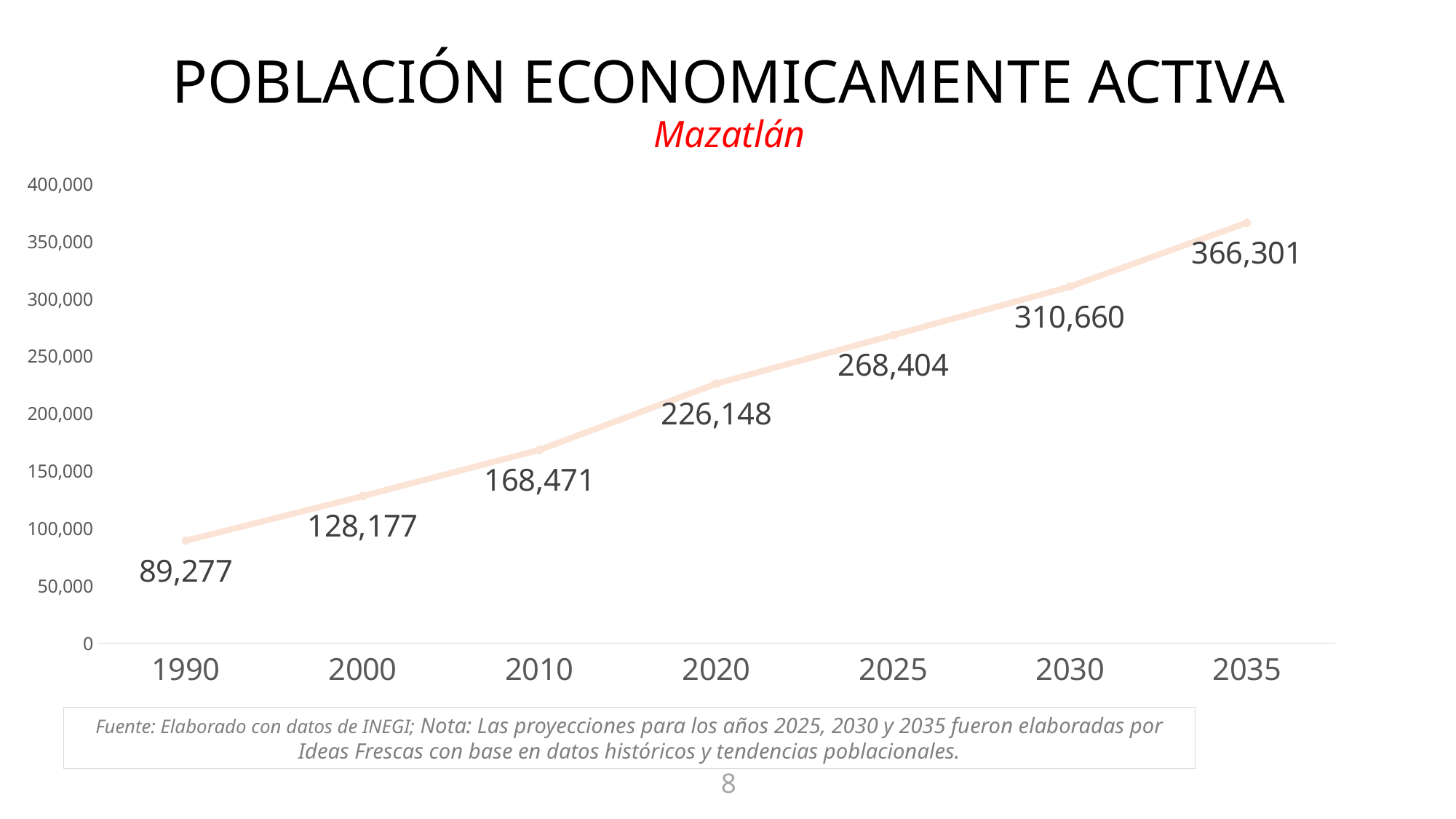
Is the value for 2020 greater or less than 200,000? greater What is the value for 2025? 268,404 What is the value for 2035? 366,301 What is the difference between the values for 2030 and 2020? 84,512 What is the value for 1990? 89,277 How many years are plotted on the x axis? 7 What is the value for 2010? 168,471 Which is larger, the value for 2000 or the value for 2010? 2010 What kind of chart is shown? line chart Do the values rise or fall from 1990 to 2035? rise Which year has the lowest value? 1990 Which year has the highest value? 2035